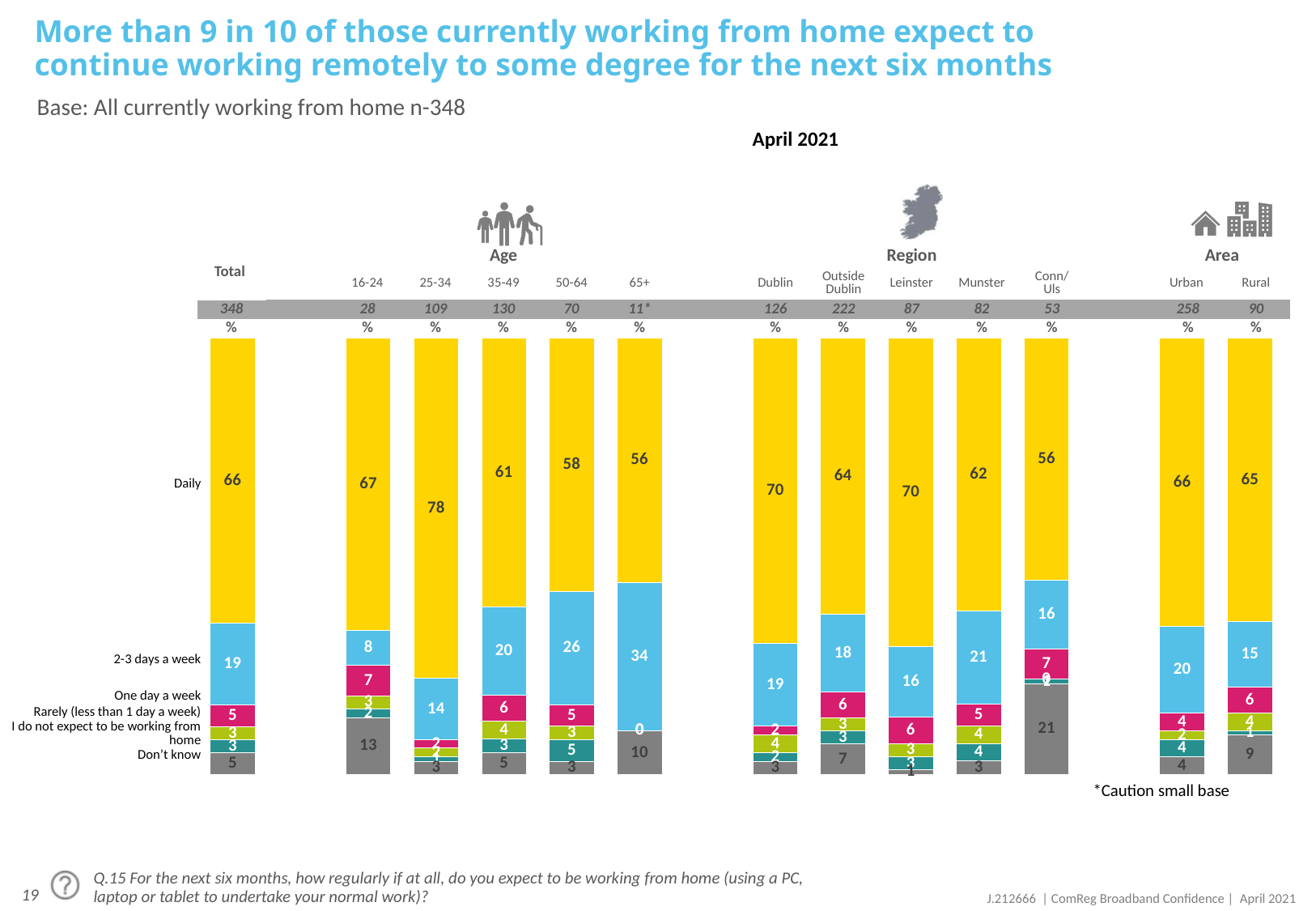
Which has a larger '2-3 days a week' value, 50-64 or 35-49? 50-64 Which age group has the highest Daily value? 25-34 What is the Daily value for the 25-34 age group? 78 What is the 'Don't know' value for Conn/Uls? 21 What is the difference between the Daily values for Urban and Rural? 1 What percentage of the Total group expect to be working from home daily? 66 How many bars are shown in the chart in total? 13 Which region has the lowest Daily value? Conn/Uls What is the difference between the Daily values for Dublin and Outside Dublin? 6 What is the base size (n) shown for the 35-49 age group? 130 What type of chart is shown on the slide? Stacked bar chart What is the '2-3 days a week' value for the 65+ age group? 34